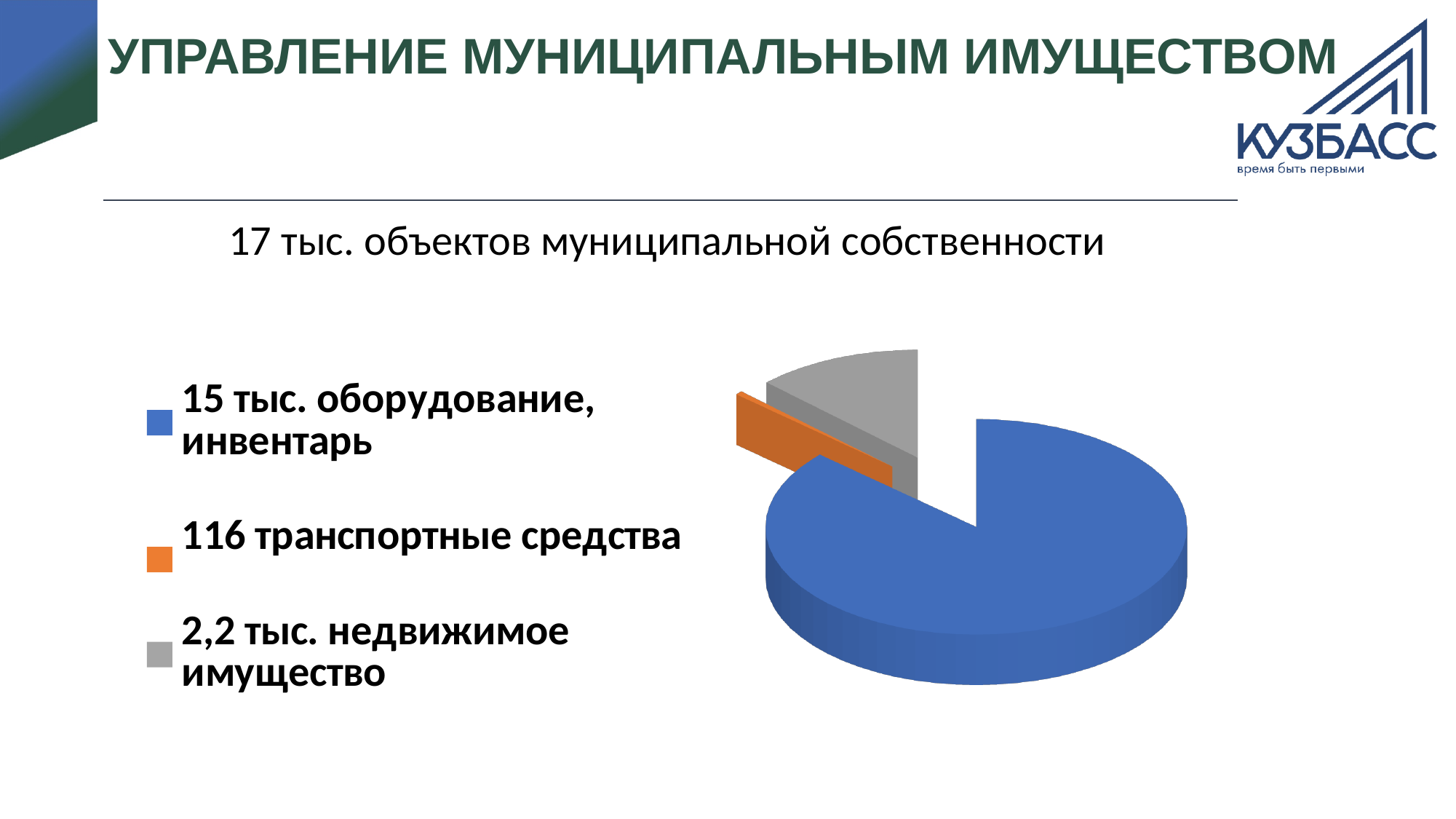
Which category has the smallest slice of the pie chart? транспортные средства What is the difference between the number of оборудование, инвентарь objects and недвижимое имущество objects? 12,8 тыс. How many транспортные средства are shown in the legend? 116 What kind of chart is shown on the slide? pie chart Which category has the largest slice of the pie chart? оборудование, инвентарь How many entries does the legend of the pie chart list? 3 How many objects of оборудование, инвентарь are shown in the legend? 15 тыс. What total number of municipal property objects is stated above the chart? 17 тыс. How many objects of недвижимое имущество are shown in the legend? 2,2 тыс. How many slices does the pie chart have? 3 What colour is the slice for транспортные средства? orange Which is larger: the slice for недвижимое имущество or the slice for транспортные средства? недвижимое имущество